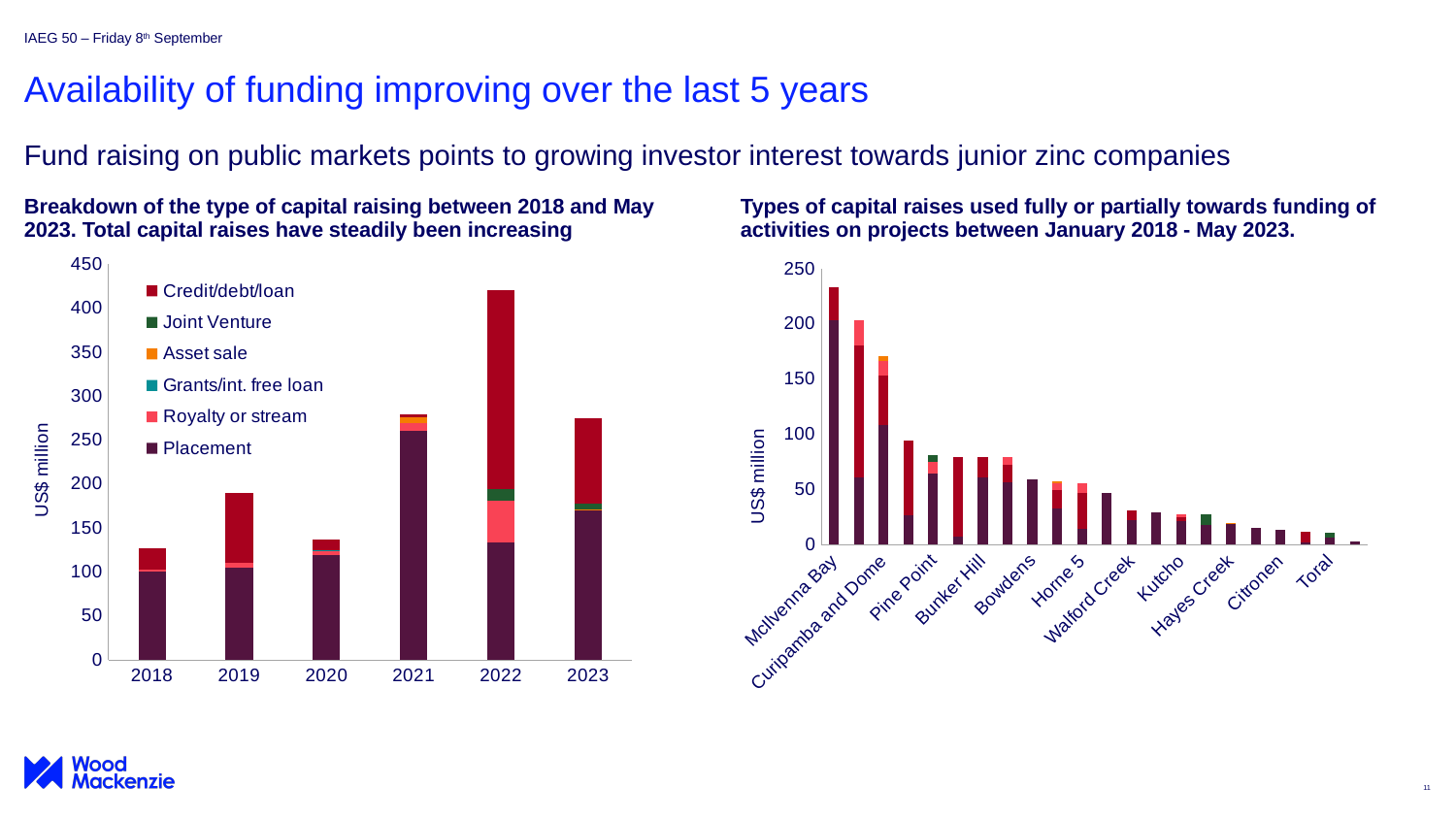
In the right chart (capital raises by project), which project has the highest total? McIlvenna Bay In the left chart (capital raising by type), which year has the highest total capital raised? 2022 In the left chart (capital raising by type), is the total for 2021 greater or less than 250? greater What kind of chart is the left chart, 'Breakdown of the type of capital raising between 2018 and May 2023'? Stacked bar chart In the left chart (capital raising by type), how many years are shown on the x axis? 6 In the left chart (capital raising by type), how many series does the legend list? 6 In the left chart (capital raising by type), what is the label on the y axis? US$ million In the right chart (capital raises by project), is the total for McIlvenna Bay greater or less than 200? greater In the left chart (capital raising by type), is the total for 2022 greater or less than 400? greater In the left chart (capital raising by type), which year has the lowest total capital raised? 2018 What kind of chart is the right chart, 'Types of capital raises used fully or partially towards funding of activities on projects'? Stacked bar chart In the left chart (capital raising by type), which year has the larger total, 2019 or 2020? 2019